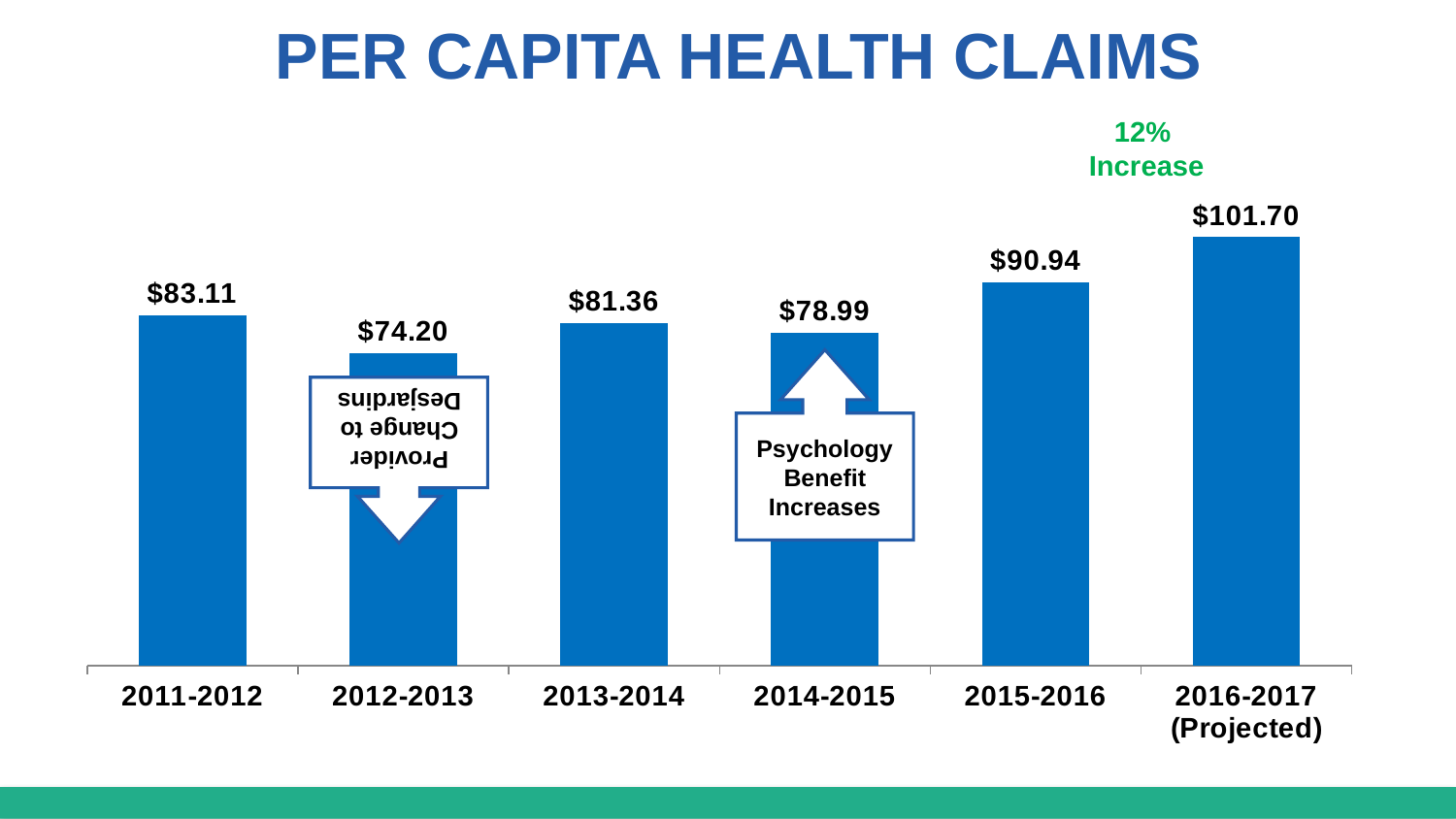
Which period has the lowest per capita health claims? 2012-2013 What is the per capita health claims value for 2015-2016? $90.94 Which period has the highest per capita health claims? 2016-2017 (Projected) Which is larger, the value for 2013-2014 or the value for 2014-2015? 2013-2014 How many periods are shown on the x axis? 6 What percentage increase is annotated above the 2016-2017 (Projected) bar? 12% What is the projected per capita health claims value for 2016-2017? $101.70 What is the difference between the 2015-2016 value and the 2014-2015 value? $11.95 What is the per capita health claims value for 2011-2012? $83.11 Do the values rise or fall from 2014-2015 to 2016-2017 (Projected)? Rise What kind of chart is shown on the slide? Bar chart What is the per capita health claims value for 2012-2013? $74.20